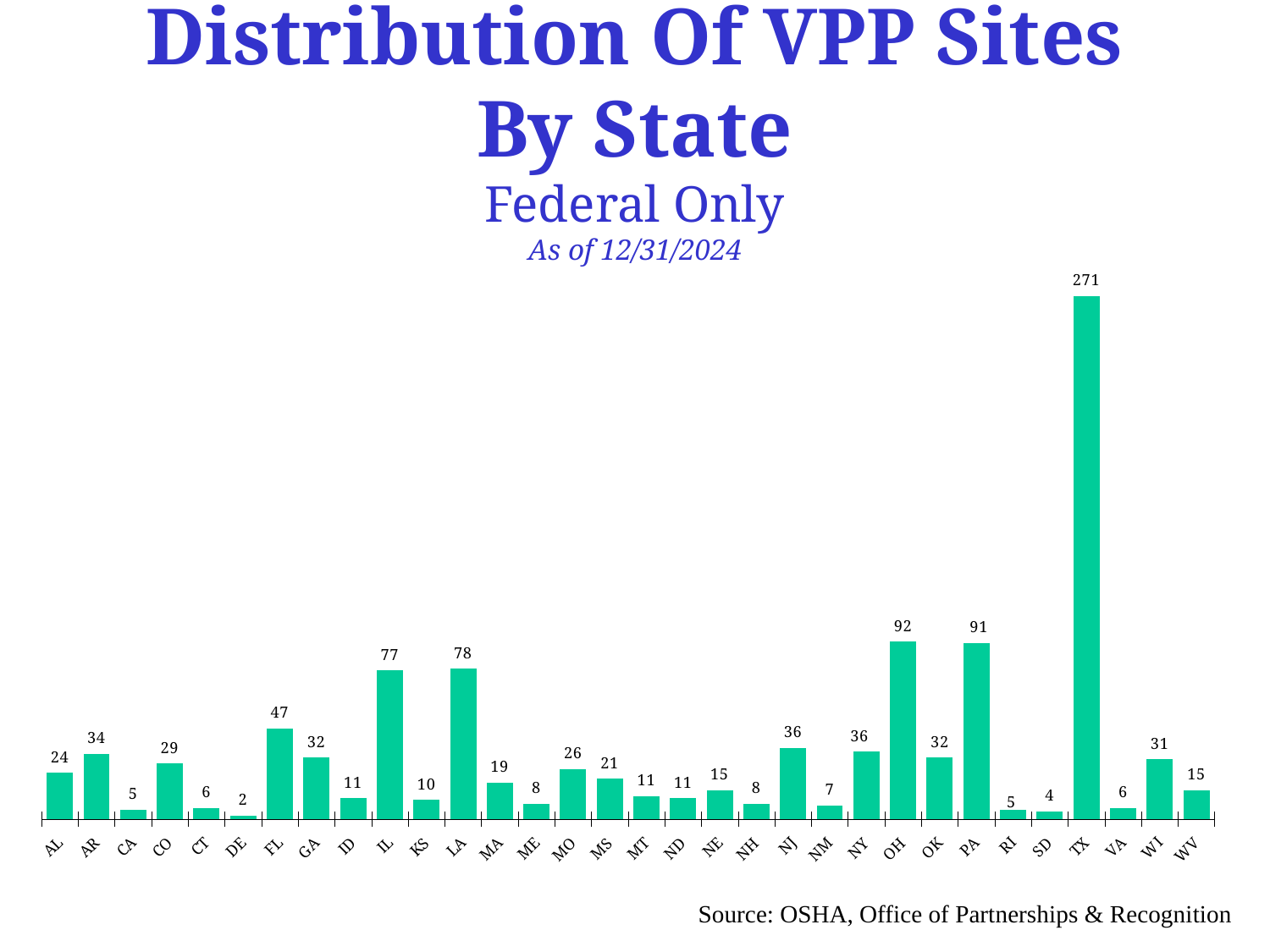
Which state has the highest number of VPP sites? TX Which has more VPP sites, FL or GA? FL What is the difference between the values for TX and OH? 179 How many states are shown on the x axis of the chart? 32 What date is the chart data current as of? 12/31/2024 What is the difference between the values for OH and PA? 1 Which has more VPP sites, IL or LA? LA How many VPP sites does Texas (TX) have? 271 Which state has the lowest number of VPP sites? DE What is the value shown for OH? 92 What is the value shown for LA? 78 What type of chart is used to show the distribution of VPP sites by state? Bar chart